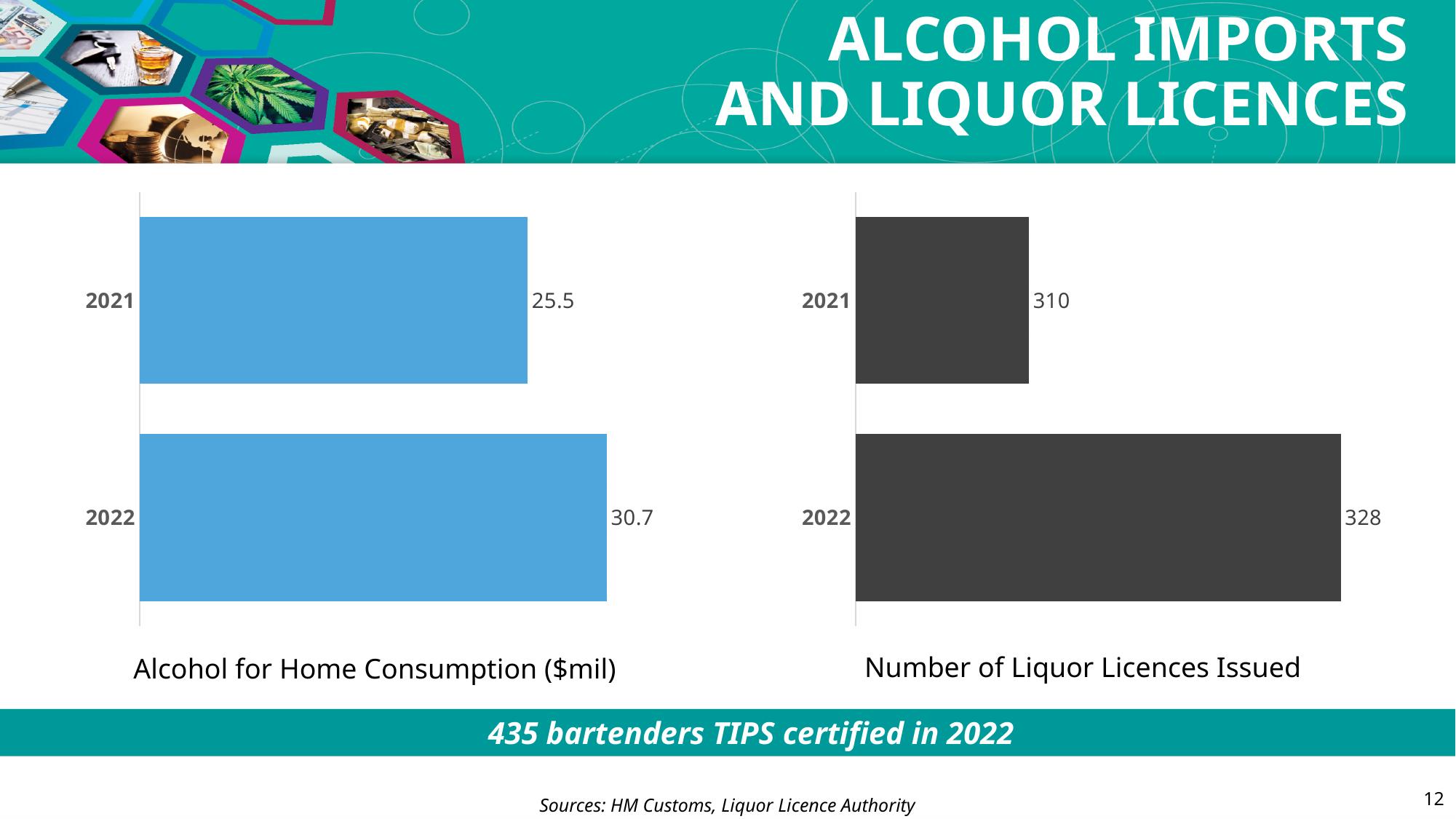
In the 'Number of Liquor Licences Issued' chart, how many more licences were issued in 2022 than in 2021? 18 In the 'Alcohol for Home Consumption ($mil)' chart, what is the value for 2022? 30.7 In the 'Number of Liquor Licences Issued' chart, is the value for 2022 larger or smaller than the value for 2021? larger In the 'Number of Liquor Licences Issued' chart, what is the value for 2021? 310 What kind of chart is the 'Number of Liquor Licences Issued' chart? bar chart How many categories (years) are shown in the 'Alcohol for Home Consumption ($mil)' chart? 2 In the 'Number of Liquor Licences Issued' chart, which year has the lower value? 2021 In the 'Number of Liquor Licences Issued' chart, what is the value for 2022? 328 In the 'Alcohol for Home Consumption ($mil)' chart, what is the difference between the 2022 and 2021 values? 5.2 What colour are the bars in the 'Alcohol for Home Consumption ($mil)' chart? blue In the 'Alcohol for Home Consumption ($mil)' chart, which year has the higher value? 2022 In the 'Alcohol for Home Consumption ($mil)' chart, what is the value for 2021? 25.5